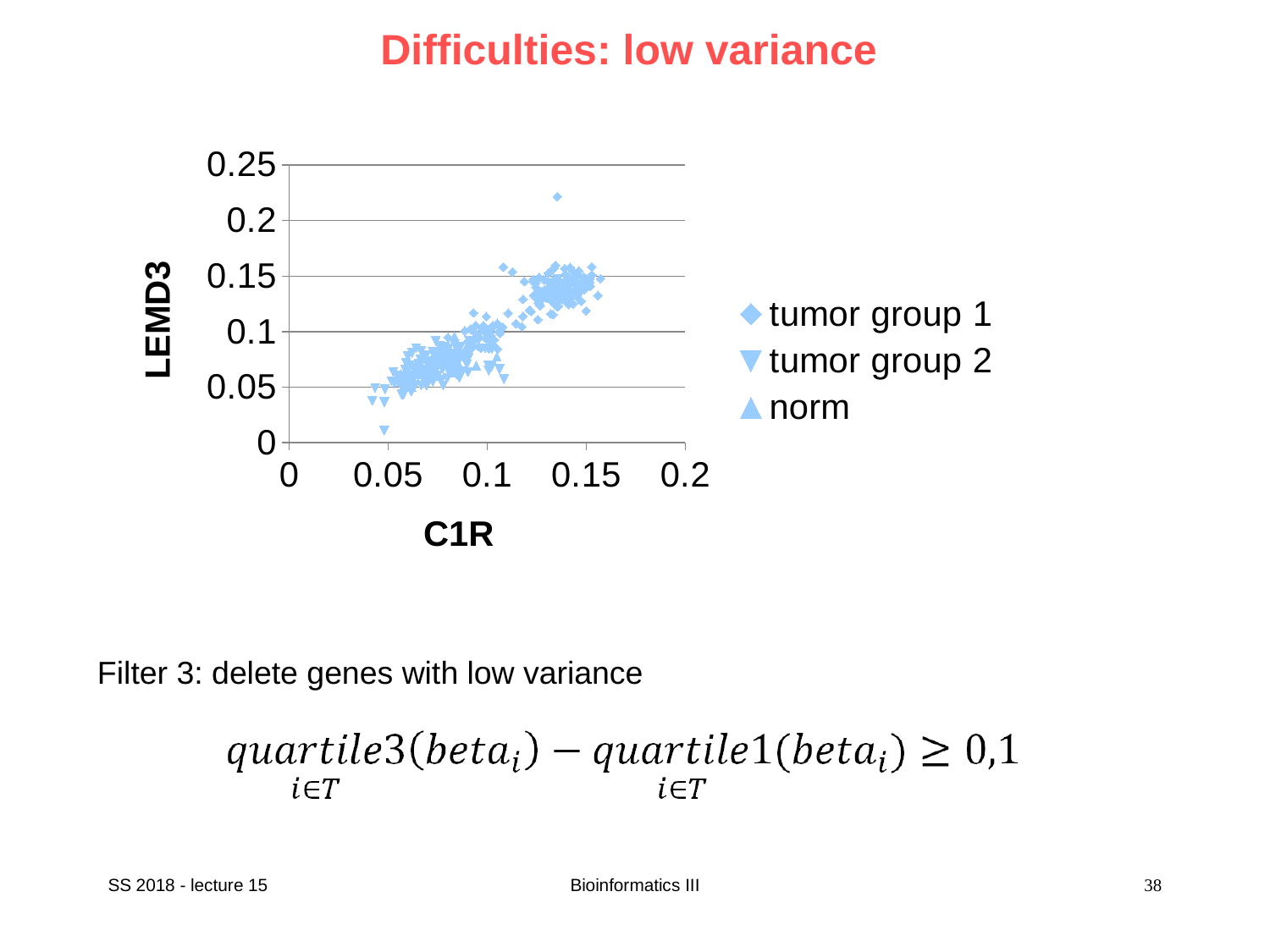
What is the largest tick value shown on the y axis of the chart? 0.25 What is the title of the y axis of the chart? LEMD3 How many series does the legend of the chart list? 3 What is the title of the x axis of the chart? C1R Is the LEMD3 value of the lowest point in the chart greater or less than 0.05? less What kind of chart is shown on the slide? scatter plot Is the C1R value of the highest point in the chart greater or less than 0.1? greater Is the LEMD3 value of the highest point in the chart greater or less than 0.2? greater Do the LEMD3 values tend to rise or fall as C1R increases along the x axis? rise